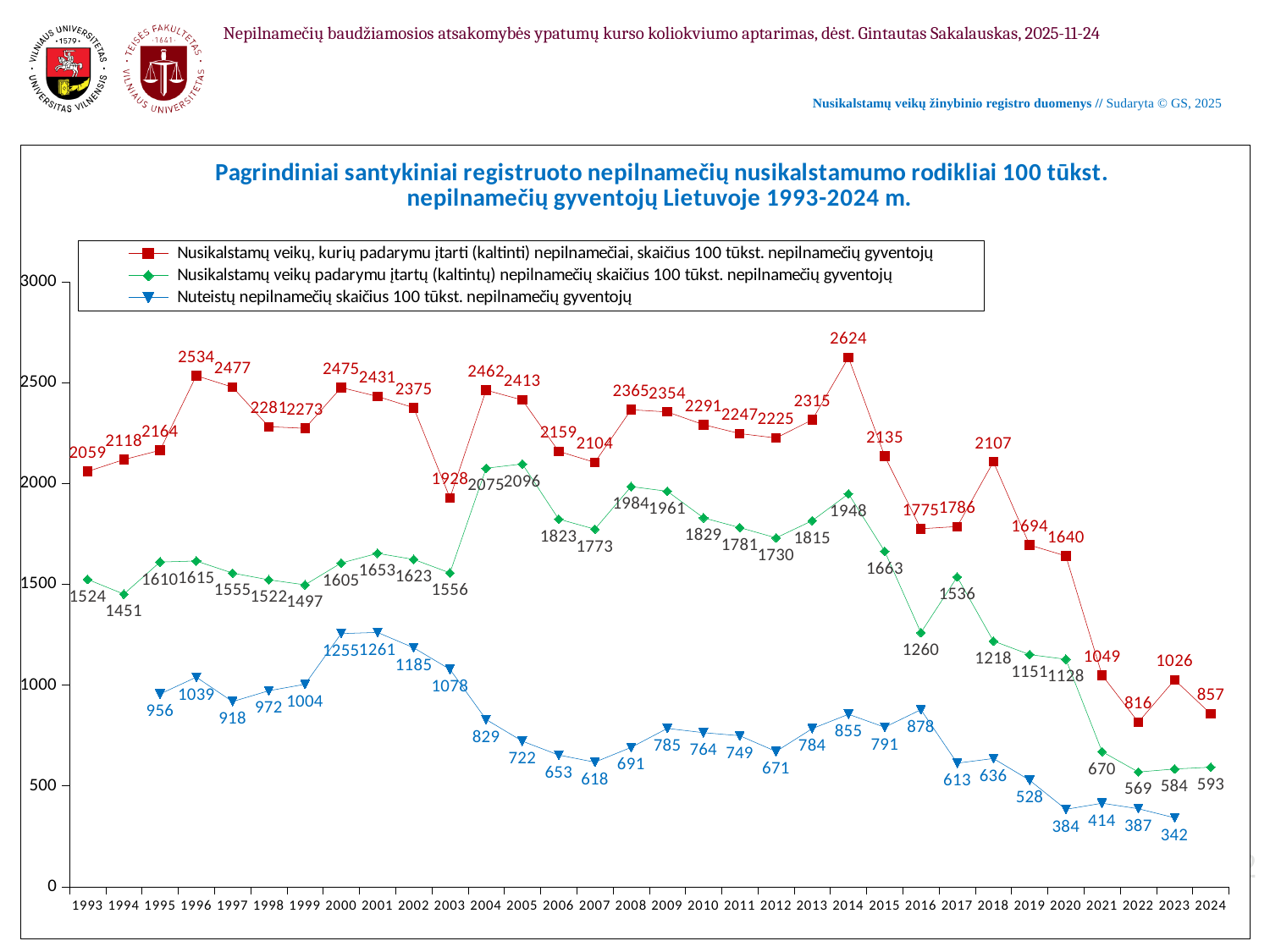
How many series does the legend list? 3 What is the value of the red series (Nusikalstamų veikų, kurių padarymu įtarti (kaltinti) nepilnamečiai) in 2014? 2624 What is the difference between the red series values in 2014 and 2015? 489 How many years are shown on the x axis? 32 Is the blue series value in 2001 greater or less than 1000? greater Does the green series rise or fall between 2020 and 2022? Fall Which is larger: the green series value in 2004 or the red series value in 2003? Green series value in 2004 (2075) What is the value of the blue series (Nuteistų nepilnamečių skaičius) in 2023? 342 In which year does the red series reach its highest value? 2014 In which year does the red series reach its lowest value? 2022 What is the value of the green series (Nusikalstamų veikų padarymu įtartų (kaltintų) nepilnamečių skaičius) in 2005? 2096 What type of chart is shown on the slide? Line chart